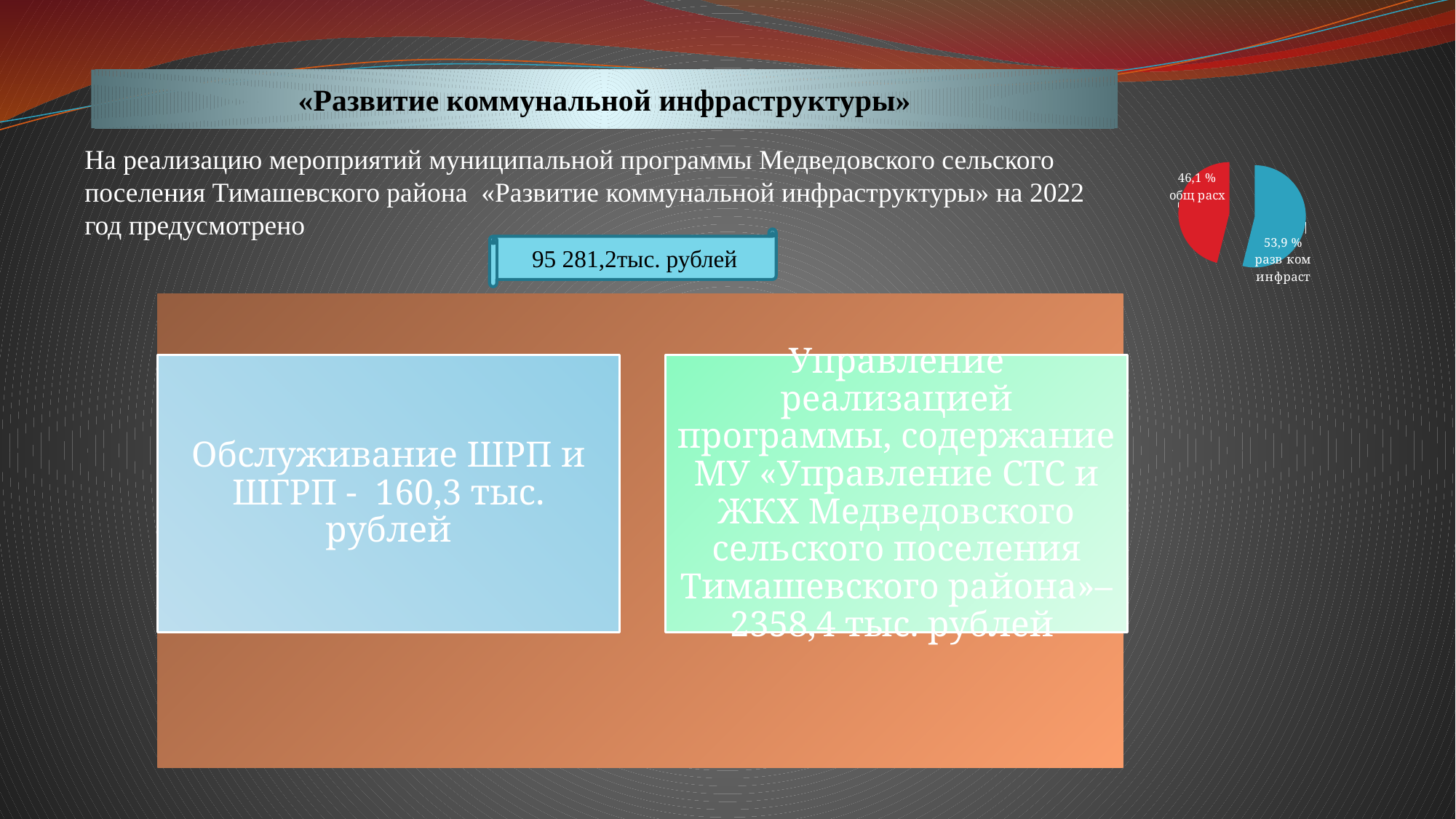
In the pie chart, which is larger: the "общ расх" slice or the "разв ком инфраст" slice? разв ком инфраст What share of the pie chart is labelled "разв ком инфраст"? 53,9 % What colour is the "разв ком инфраст" slice in the pie chart? blue What share of the pie chart is labelled "общ расх"? 46,1 % Is the share of the "разв ком инфраст" slice in the pie chart greater or less than 50%? greater Is the share of the "общ расх" slice in the pie chart greater or less than 50%? less Which slice of the pie chart is the smallest? общ расх How many slices does the pie chart have? 2 What colour is the "общ расх" slice in the pie chart? red What is the difference in percentage points between the "разв ком инфраст" slice and the "общ расх" slice in the pie chart? 7,8 % Which slice of the pie chart is the largest? разв ком инфраст What kind of chart is shown in the top right of the slide? pie chart